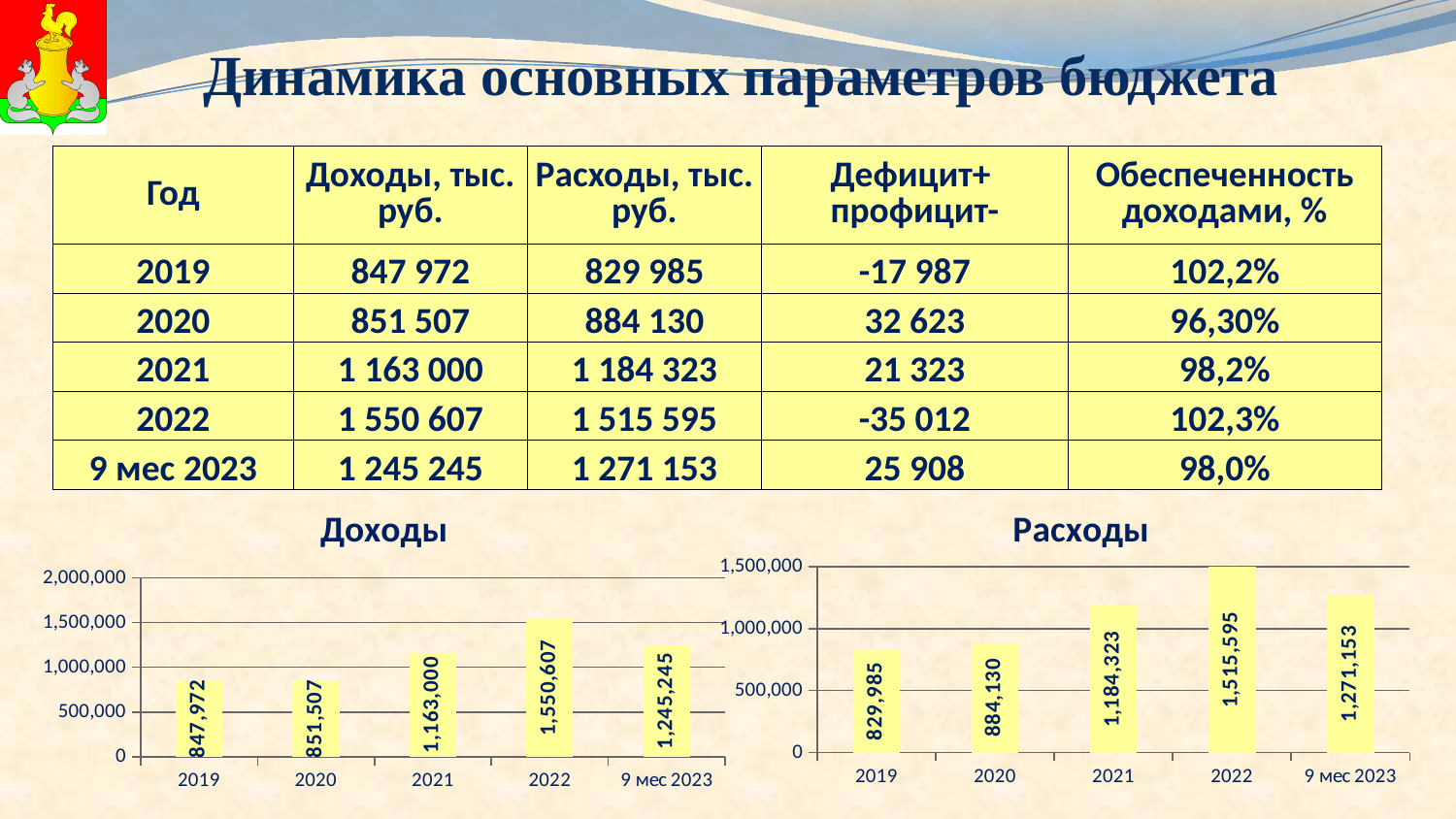
In the "Расходы" chart, what is the difference between the values for 2022 and 9 мес 2023? 244,442 What type of chart is the "Расходы" chart? bar chart In the "Доходы" chart, what is the difference between the values for 2022 and 2021? 387,607 In the "Расходы" chart, what is the value for 2020? 884,130 How many categories are shown on the x axis of the "Доходы" chart? 5 In the "Доходы" chart, do the values rise or fall from 2019 to 2022? rise In the "Доходы" chart, which year has the highest value? 2022 In the "Доходы" chart, is the value for 2022 greater or less than 1,500,000? greater In the "Доходы" chart, what is the value for 2021? 1,163,000 In the "Расходы" chart, which is larger: the value for 2021 or the value for 9 мес 2023? 9 мес 2023 In the "Расходы" chart, which category has the lowest value? 2019 In the "Расходы" chart, is the value for 2019 greater or less than 1,000,000? less